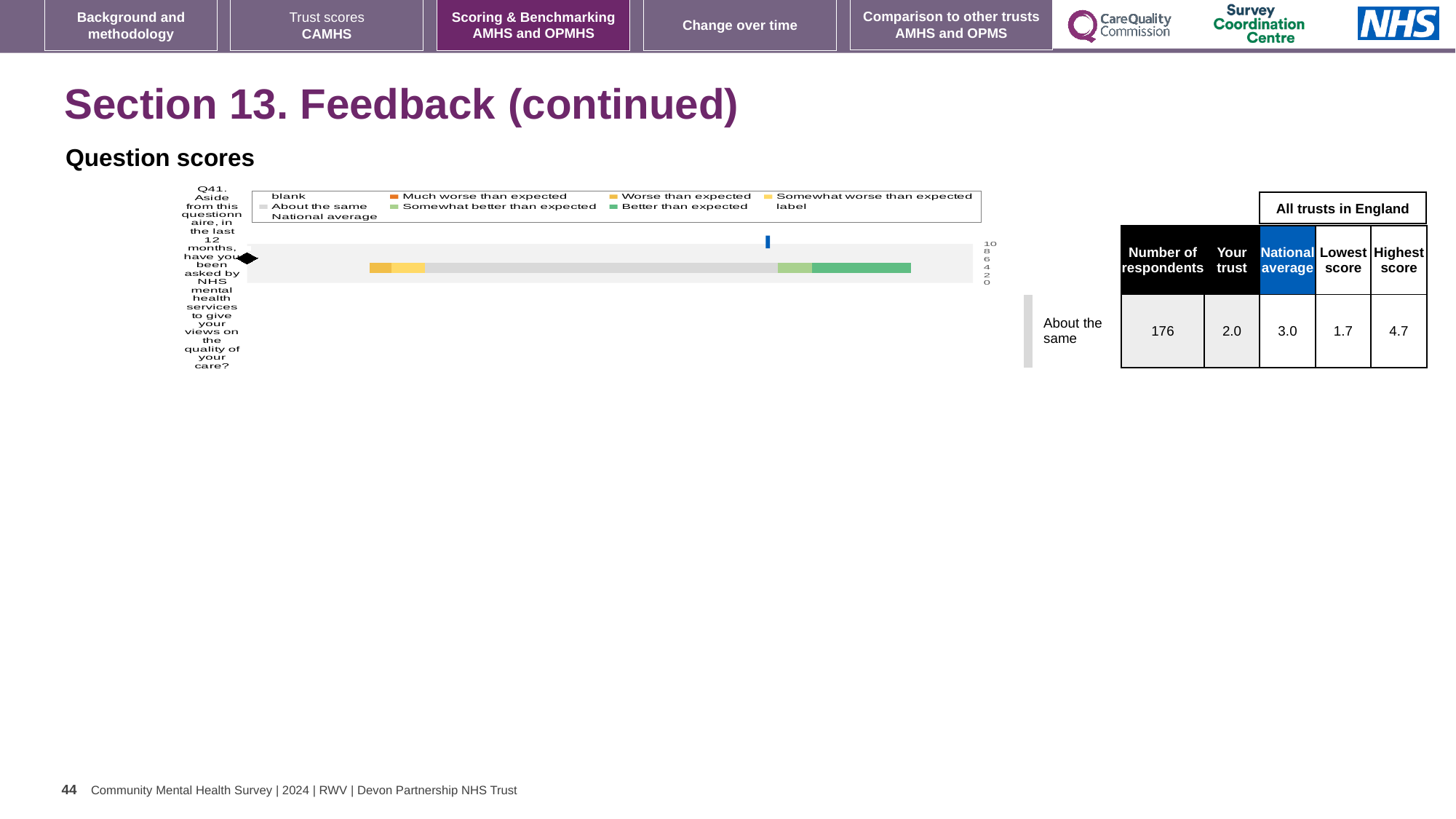
What benchmark category is the trust's Q41 result labelled as? About the same In the table next to the chart, what is the national average for Q41? 3.0 How many questions (categories) are plotted in the chart? 1 What colour does the legend use for 'Better than expected'? green What kind of chart is shown under 'Question scores'? bar chart In the table next to the chart, what is the highest score among all trusts in England for Q41? 4.7 Which question number is plotted in the chart? Q41 In the table next to the chart, what is the 'Your trust' score for Q41? 2.0 In the table next to the chart, what is the number of respondents for Q41? 176 What is the difference between the highest score and the lowest score for Q41? 3.0 Which is larger for Q41, the 'Your trust' score or the national average? national average In the table next to the chart, what is the lowest score among all trusts in England for Q41? 1.7